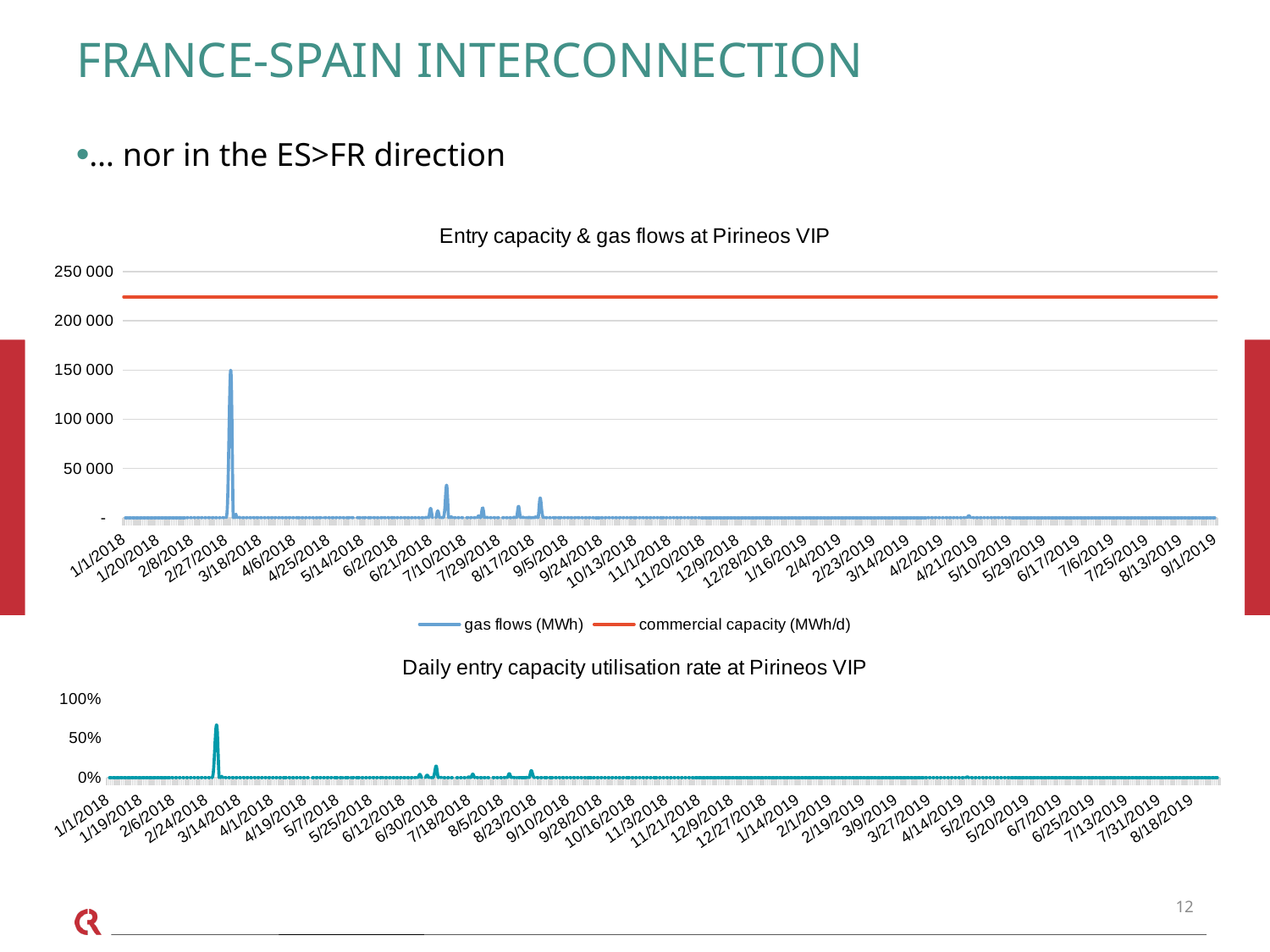
In the chart titled "Entry capacity & gas flows at Pirineos VIP", is the commercial capacity (MWh/d) line greater or less than 250 000? less In the chart titled "Entry capacity & gas flows at Pirineos VIP", which series is shown in red? commercial capacity (MWh/d) In the chart titled "Daily entry capacity utilisation rate at Pirineos VIP", what kind of chart is shown? line chart In the chart titled "Daily entry capacity utilisation rate at Pirineos VIP", is the highest peak of the utilisation rate greater or less than 100%? less In the chart titled "Entry capacity & gas flows at Pirineos VIP", which series has the higher values across the whole period, gas flows (MWh) or commercial capacity (MWh/d)? commercial capacity (MWh/d) In the chart titled "Entry capacity & gas flows at Pirineos VIP", how many series does the legend list? 2 In the chart titled "Entry capacity & gas flows at Pirineos VIP", is the highest peak of gas flows (MWh) greater or less than 100 000? greater In the chart titled "Entry capacity & gas flows at Pirineos VIP", what kind of chart is shown? line chart In the chart titled "Entry capacity & gas flows at Pirineos VIP", does the commercial capacity (MWh/d) line rise, fall or stay flat along the x axis? stay flat What is the title of the lower chart on the slide? Daily entry capacity utilisation rate at Pirineos VIP